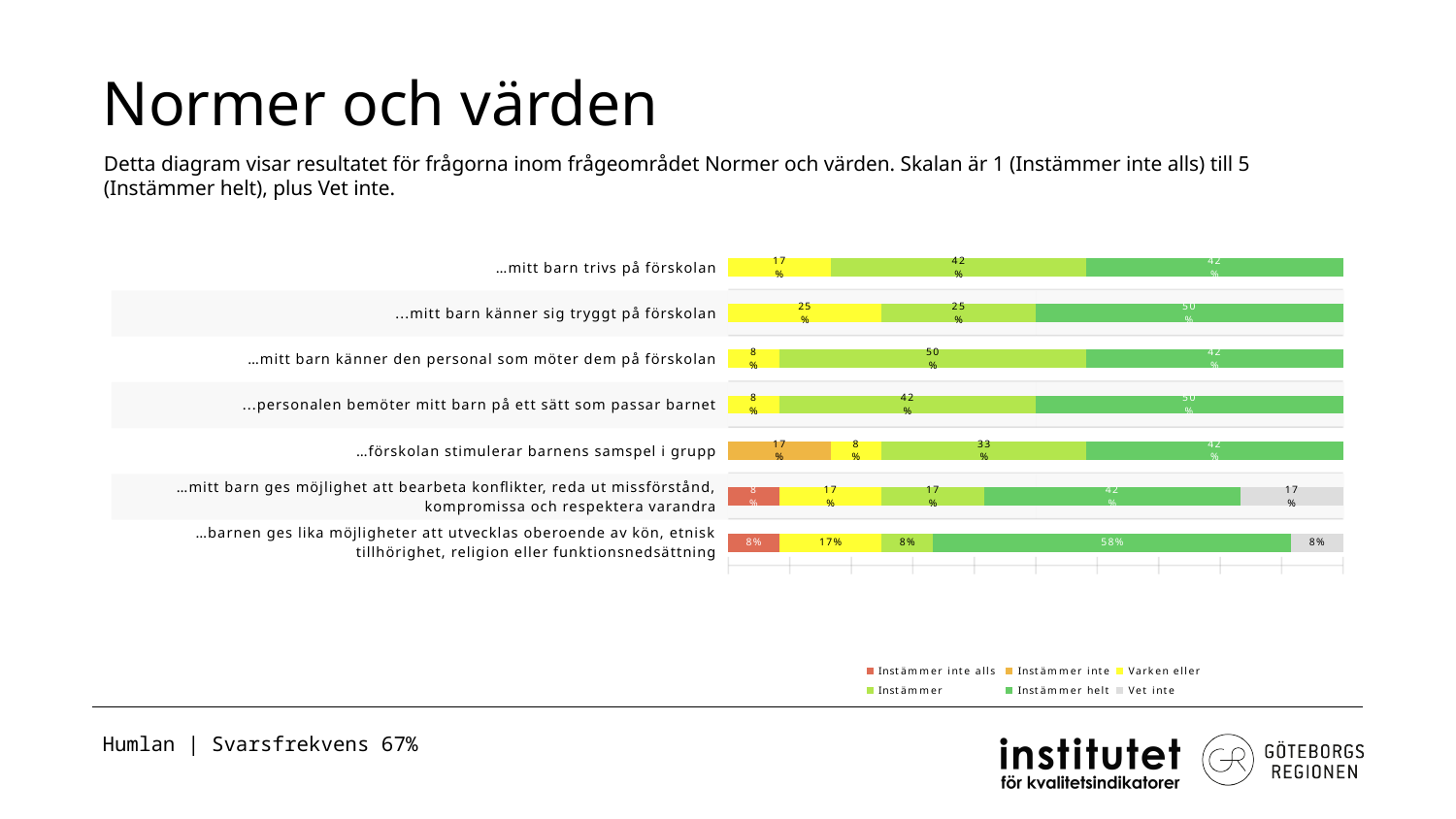
What is the 'Instämmer helt' share for '…mitt barn känner sig tryggt på förskolan'? 50% What is the 'Varken eller' share for '…mitt barn trivs på förskolan'? 17% What colour represents 'Instämmer helt' in the legend? Green What kind of chart is shown on the slide? Stacked bar chart How many statements (categories) are plotted in the chart? 7 What is the 'Vet inte' share for '…barnen ges lika möjligheter att utvecklas oberoende av kön, etnisk tillhörighet, religion eller funktionsnedsättning'? 8% What is the 'Instämmer inte' share for '…förskolan stimulerar barnens samspel i grupp'? 17% Which statement has the highest 'Instämmer helt' share? …barnen ges lika möjligheter att utvecklas oberoende av kön, etnisk tillhörighet, religion eller funktionsnedsättning How many series does the legend list? 6 What is the 'Instämmer' share for '…mitt barn känner den personal som möter dem på förskolan'? 50% What is the difference between the 'Instämmer helt' share and the 'Instämmer' share for '…förskolan stimulerar barnens samspel i grupp'? 9% Which is larger for '…personalen bemöter mitt barn på ett sätt som passar barnet': the 'Instämmer' share or the 'Instämmer helt' share? Instämmer helt